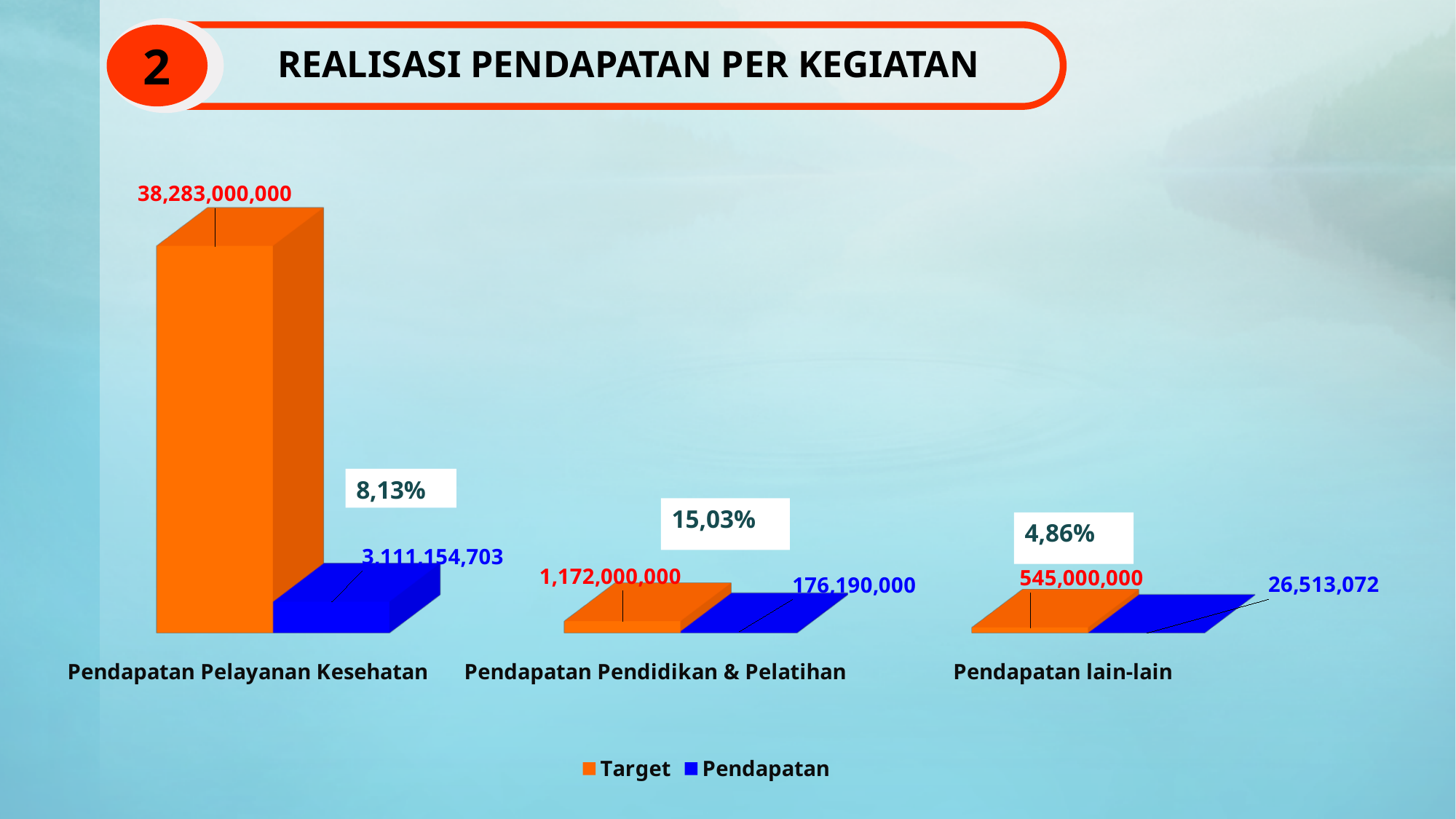
What is the Pendapatan value for Pendapatan Pendidikan & Pelatihan? 176,190,000 What is the Pendapatan value for Pendapatan lain-lain? 26,513,072 What is the difference between the Target and Pendapatan values for Pendapatan lain-lain? 518,486,928 How many series does the legend list? 2 Which is larger for Pendapatan Pelayanan Kesehatan: the Target value or the Pendapatan value? Target What kind of chart is shown on the slide? Bar chart What is the Target value for Pendapatan Pelayanan Kesehatan? 38,283,000,000 Which category has the lowest Pendapatan value? Pendapatan lain-lain What is the Target value for Pendapatan lain-lain? 545,000,000 Which category has the highest Target value? Pendapatan Pelayanan Kesehatan What is the difference between the Target and Pendapatan values for Pendapatan Pendidikan & Pelatihan? 995,810,000 How many categories are shown on the x axis of the chart? 3